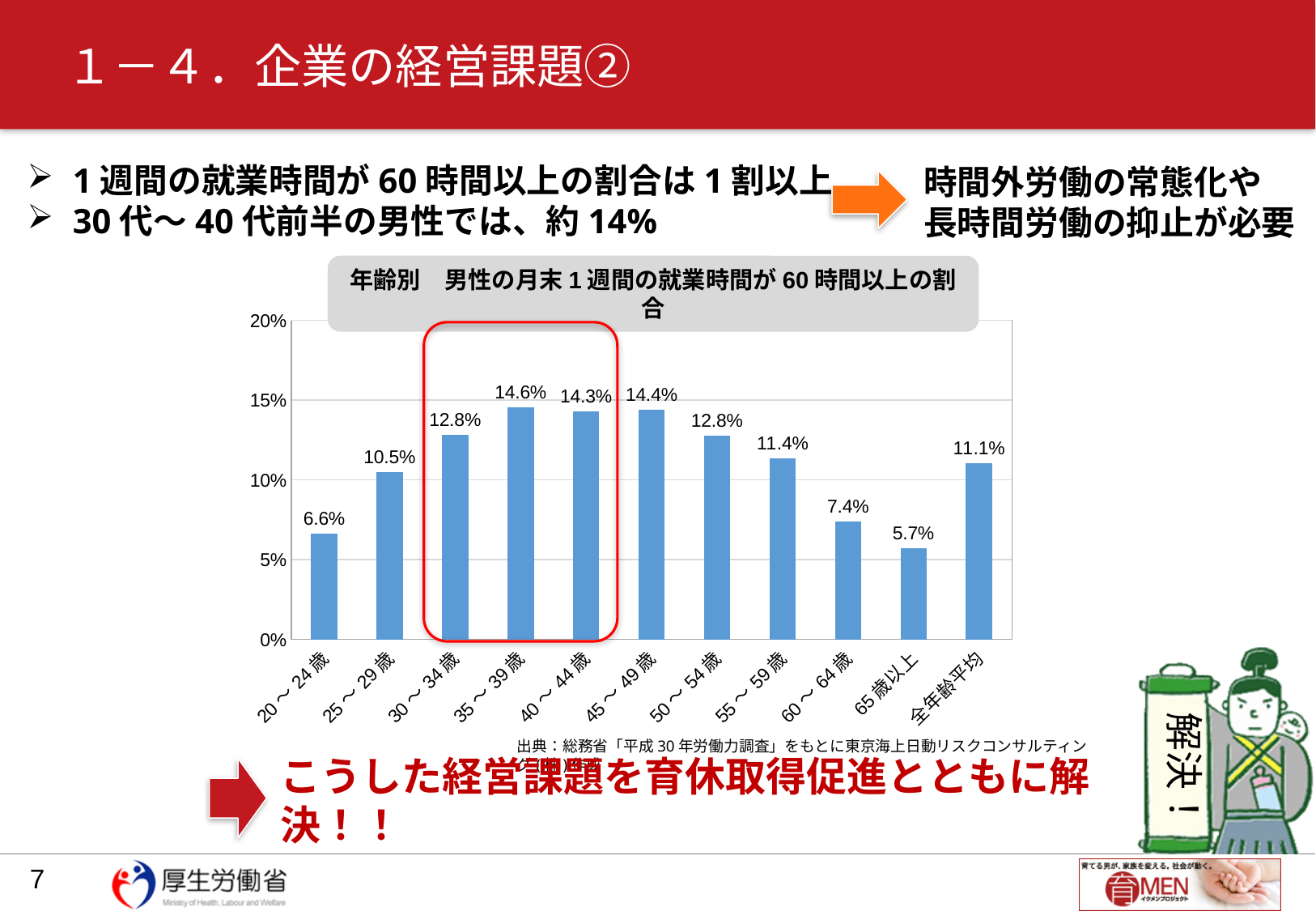
What kind of chart is shown on the slide? bar chart Which age group has the lowest value? 65歳以上 Do the values rise or fall from 45～49歳 to 65歳以上? fall What is the difference between the values for 35～39歳 and 20～24歳? 8.0% What is the value for 20～24歳? 6.6% What is the value for 60～64歳? 7.4% What is the value for 全年齢平均? 11.1% What is the value for 35～39歳? 14.6% Is the value for 45～49歳 greater or less than 10%? greater How many categories are shown on the x axis? 11 Which age group has the highest value? 35～39歳 Which is larger, the value for 25～29歳 or the value for 55～59歳? 55～59歳